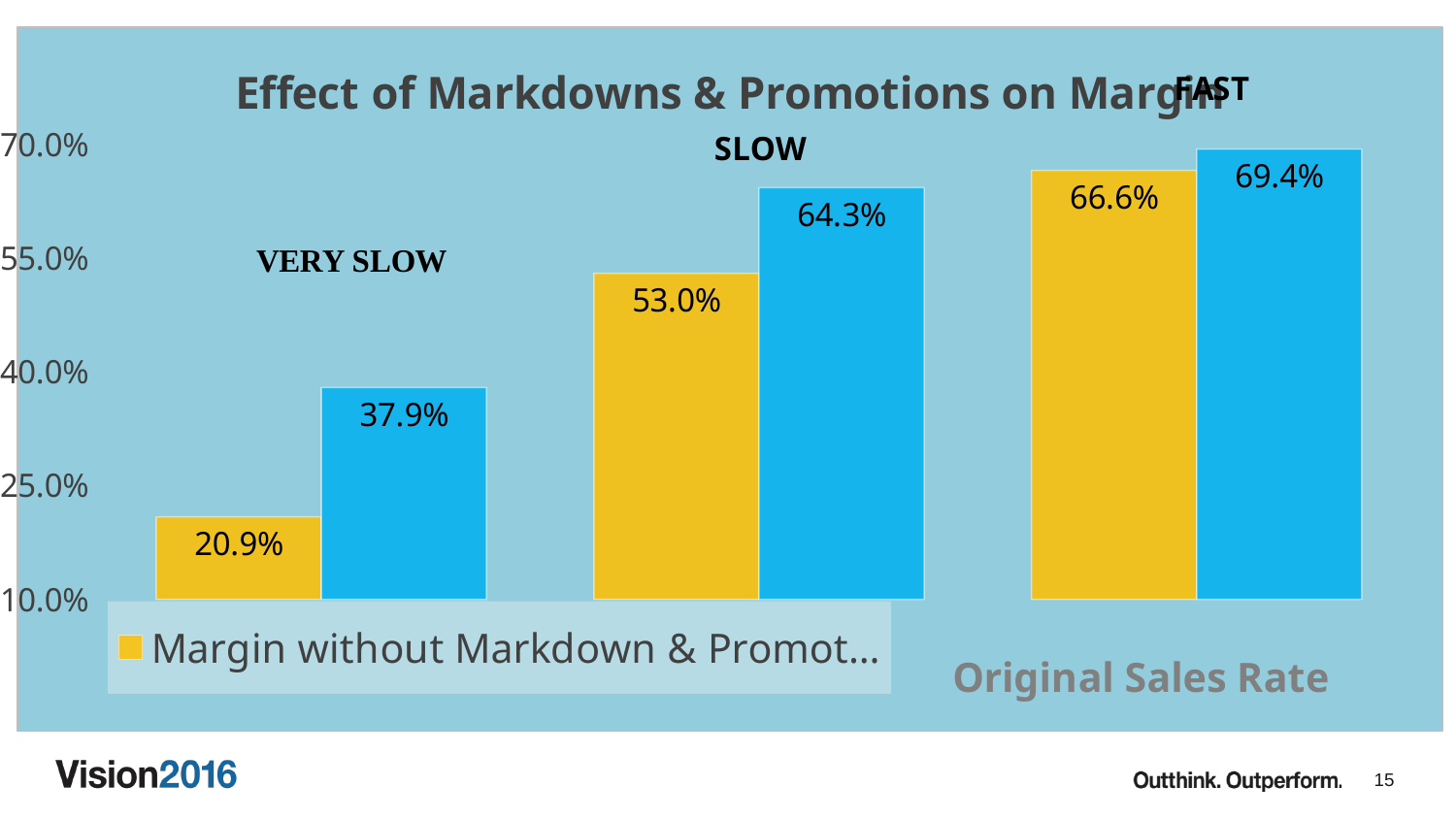
What is the value of the blue bar for SLOW? 64.3% Which category has the highest blue bar? FAST What is the value of the yellow bar for FAST? 66.6% What is the difference between the blue and yellow bars for VERY SLOW? 17.0% Which is larger: the yellow bar for SLOW or the blue bar for VERY SLOW? The yellow bar for SLOW What kind of chart is shown on the slide? Bar chart What is the difference between the blue and yellow bars for SLOW? 11.3% How many categories are shown on the x axis? 3 Do the yellow bars rise or fall from VERY SLOW to FAST? Rise Which category has the lowest yellow bar? VERY SLOW What is the value of the yellow bar for VERY SLOW? 20.9% What is the value of the blue bar for VERY SLOW? 37.9%